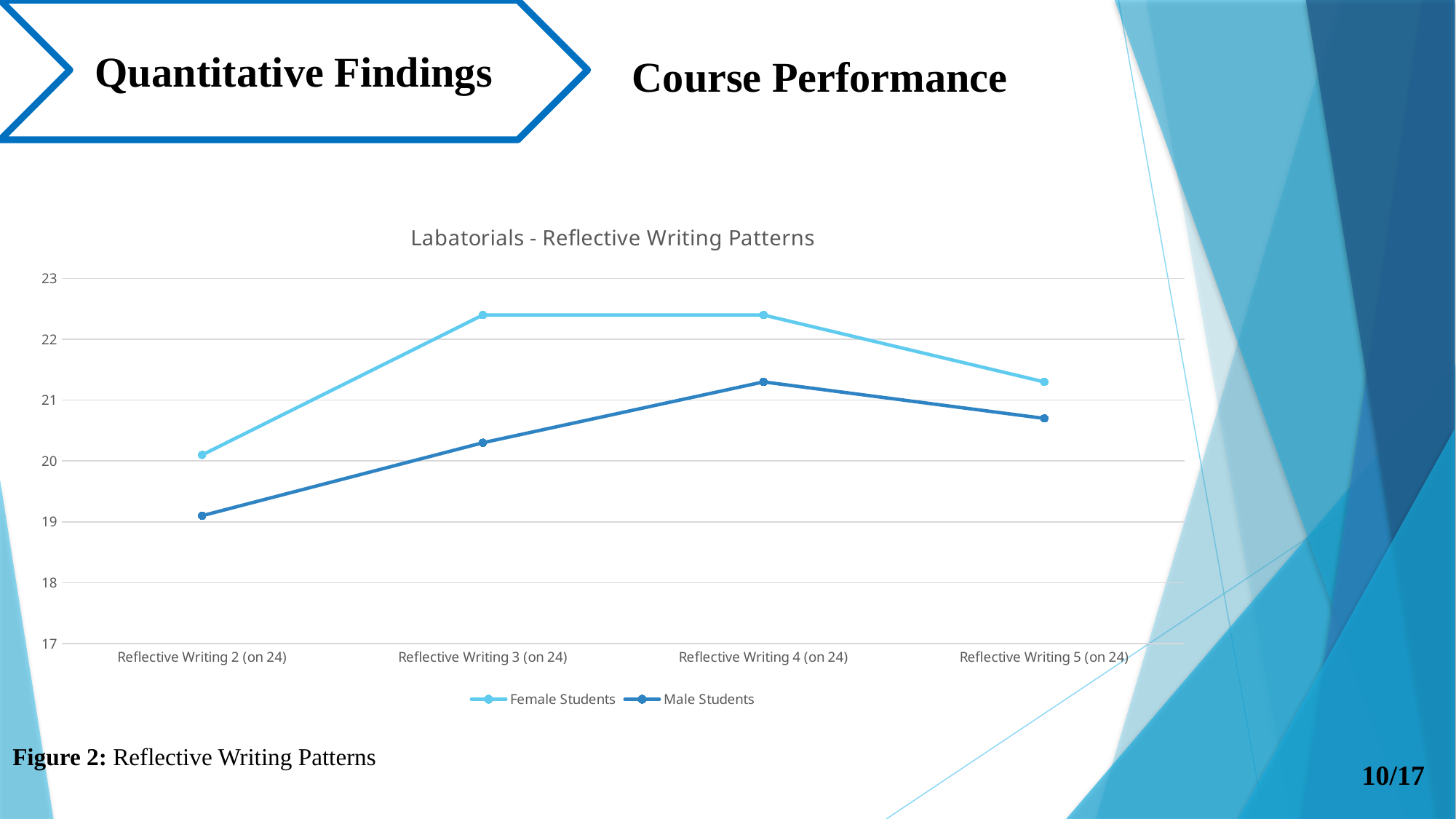
Is the value for Male Students at Reflective Writing 2 (on 24) greater or less than 20? less Is the value for Female Students at Reflective Writing 3 (on 24) greater or less than 22? greater Which category has the lowest value for Female Students? Reflective Writing 2 (on 24) At Reflective Writing 2 (on 24), which series has the larger value, Female Students or Male Students? Female Students Do the values for Male Students rise or fall from Reflective Writing 2 (on 24) to Reflective Writing 4 (on 24)? rise Which category has the highest value for Male Students? Reflective Writing 4 (on 24) How many series does the legend list? 2 What kind of chart is shown on the slide? line chart How many categories are shown on the x axis? 4 What is the title of the chart? Labatorials - Reflective Writing Patterns Which category has the lowest value for Male Students? Reflective Writing 2 (on 24) Is the value for Male Students at Reflective Writing 5 (on 24) greater or less than 21? less